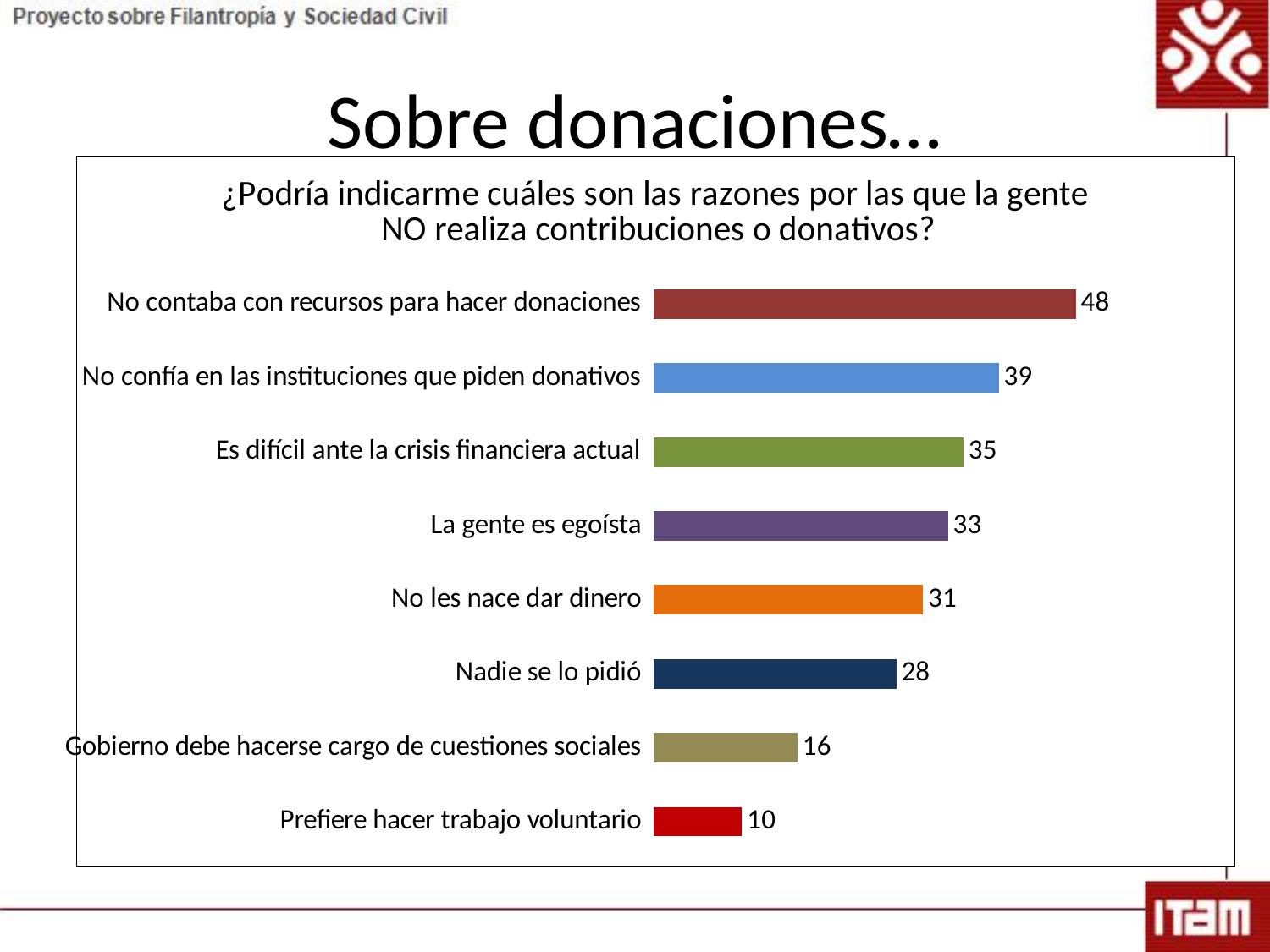
What kind of chart is shown on the slide? Bar chart Which is larger: the value for "Es difícil ante la crisis financiera actual" or the value for "No les nace dar dinero"? Es difícil ante la crisis financiera actual What is the value for "La gente es egoísta"? 33 Which category has the highest value? No contaba con recursos para hacer donaciones What is the value for "Gobierno debe hacerse cargo de cuestiones sociales"? 16 Which category has the lowest value? Prefiere hacer trabajo voluntario What is the difference between the values for "No contaba con recursos para hacer donaciones" and "Prefiere hacer trabajo voluntario"? 38 Do the values rise or fall going from the top bar to the bottom bar? Fall How many categories are shown in the chart? 8 What is the title of the chart? ¿Podría indicarme cuáles son las razones por las que la gente NO realiza contribuciones o donativos? What is the value for "No contaba con recursos para hacer donaciones"? 48 What is the difference between the values for "No confía en las instituciones que piden donativos" and "Nadie se lo pidió"? 11